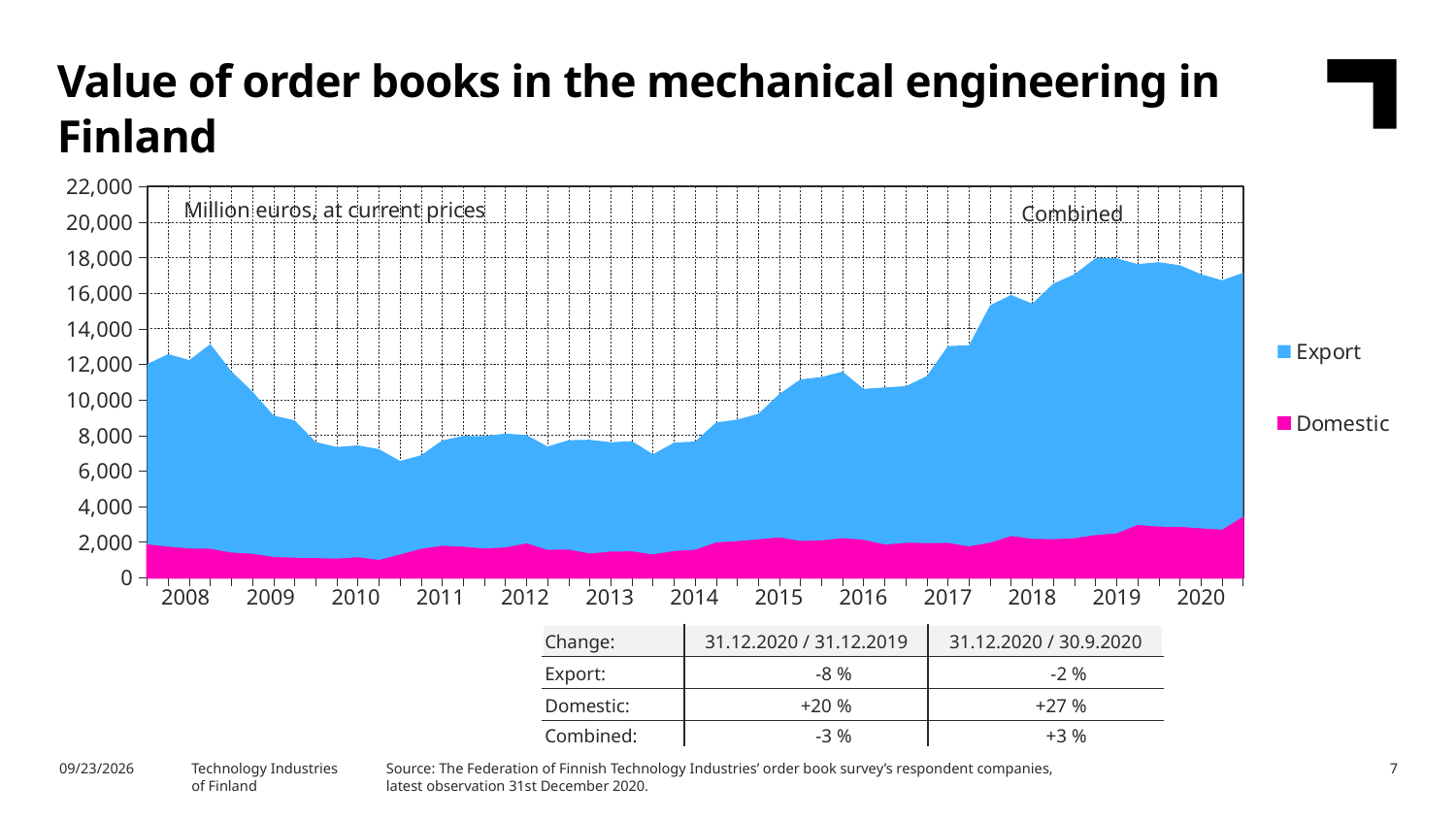
How many series does the chart legend list? 2 Which series is larger throughout the chart, Export or Domestic? Export Does the combined value of order books rise or fall between 2008 and 2010? fall Is the combined value of order books at the start of 2019 greater or less than 16,000? greater Is the Domestic value at the end of 2020 greater or less than 2,000? greater What kind of chart is shown on the slide? Stacked area chart What unit is stated in the note at the top of the chart? Million euros, at current prices Which two series are listed in the chart legend? Export and Domestic Is the combined value of order books at the start of 2008 greater or less than 10,000? greater According to the table below the chart, what is the change in Export order books from 31.12.2019 to 31.12.2020? -8 % Does the combined value of order books rise or fall between 2016 and 2019? rise